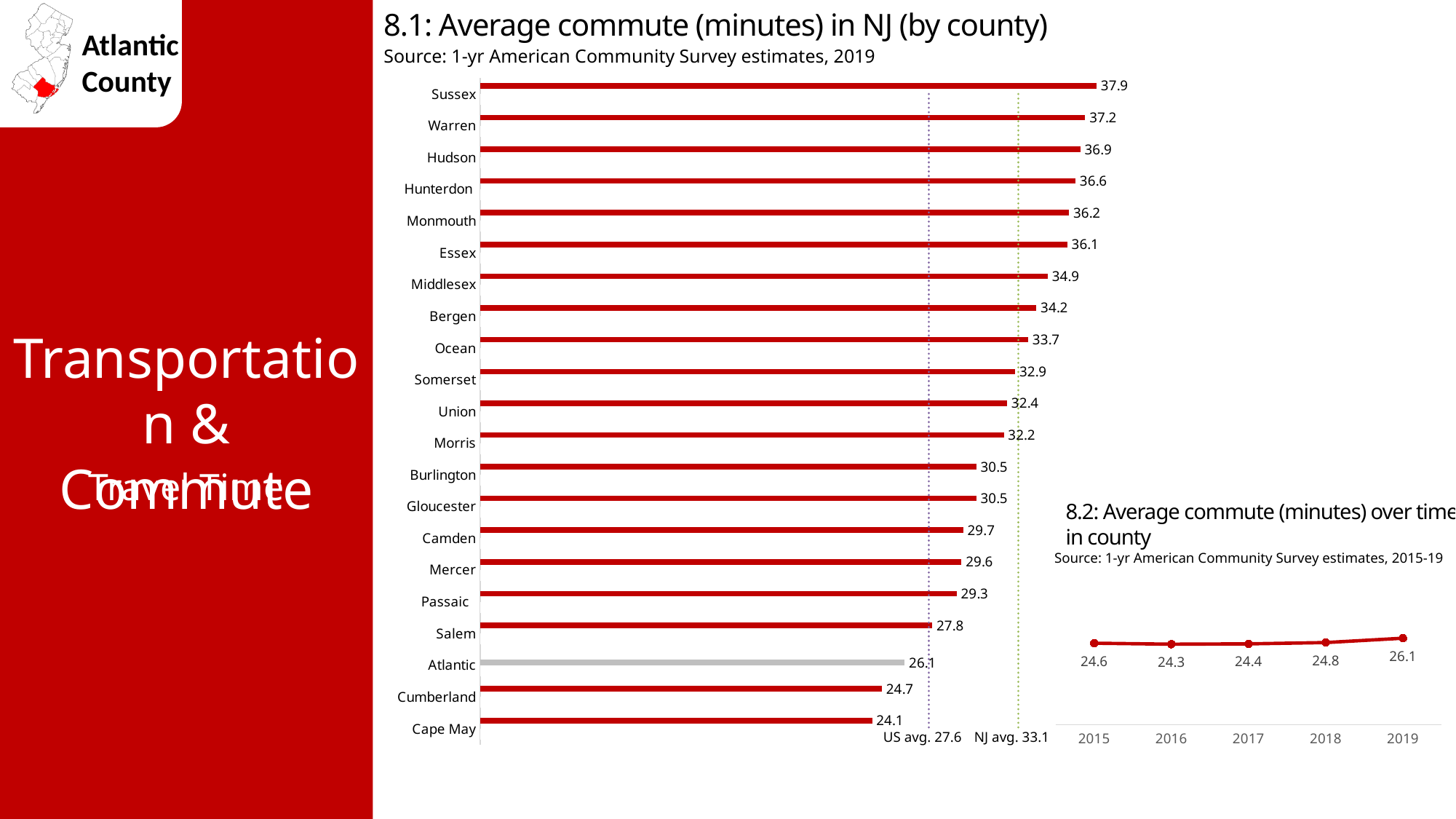
In chart 8.1 (Average commute in NJ by county), what is the average commute for Atlantic County? 26.1 In chart 8.2, how many years are plotted? 5 In chart 8.1, what is the US average commute shown by the dotted reference line? 27.6 In chart 8.1, how many counties are shown? 21 In chart 8.1, which county has the lowest average commute? Cape May What kind of chart is chart 8.1? Bar chart In chart 8.1, which county has a longer average commute, Hudson or Bergen? Hudson In chart 8.2, what is the difference between the 2019 and 2015 values? 1.5 In chart 8.1, what is the NJ average commute shown by the dotted reference line? 33.1 In chart 8.1, which county has the highest average commute? Sussex In chart 8.2 (Average commute over time in county), what was the average commute in 2017? 24.4 In chart 8.1, what is the difference between the average commute in Sussex and in Cape May? 13.8